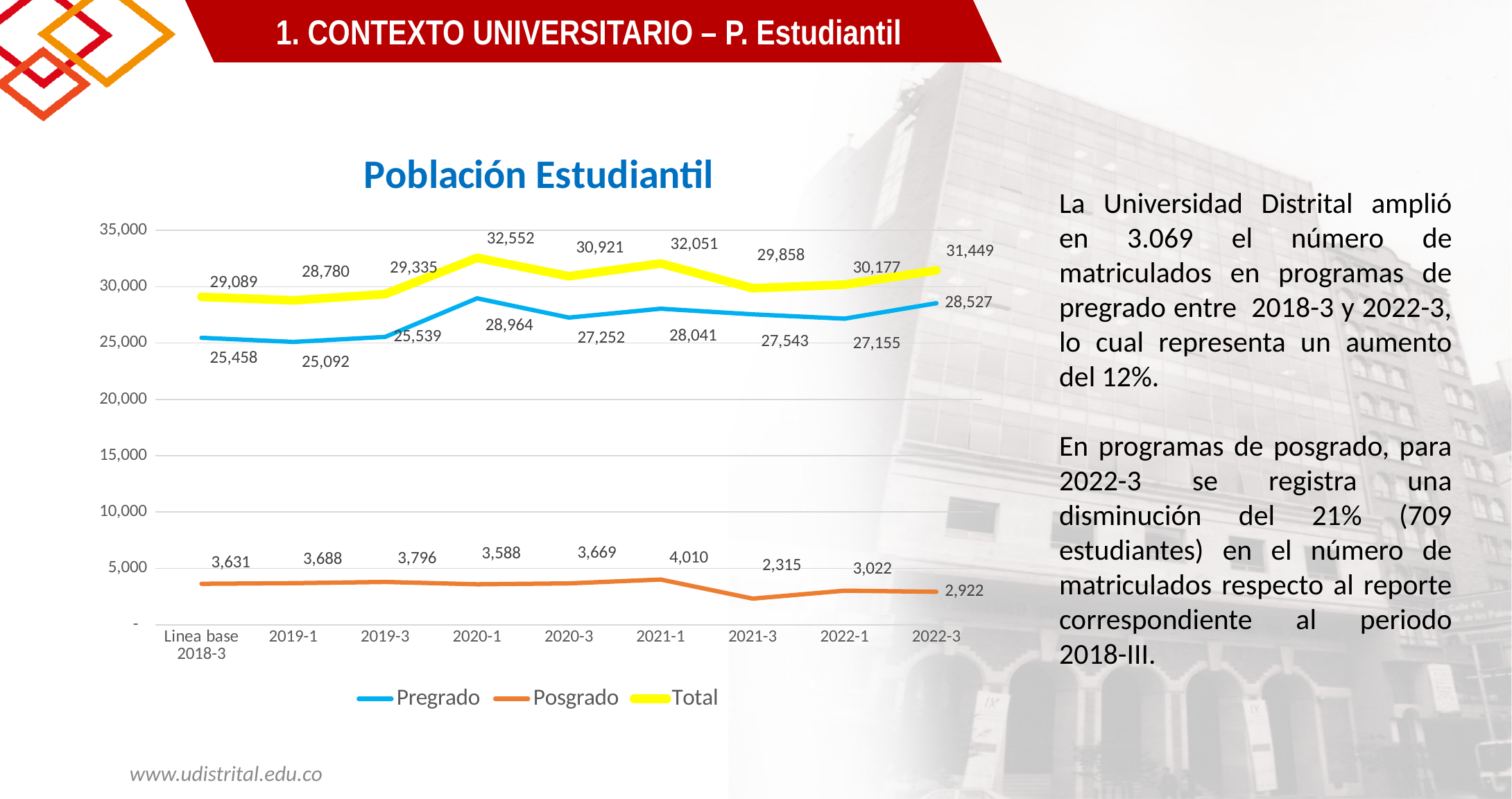
What is the title of the chart? Población Estudiantil What is the Total value for 2022-3? 31,449 What is the Posgrado value for 2021-3? 2,315 What is the difference between the Pregrado values for 2022-3 and Linea base 2018-3? 3,069 How many series does the legend list? 3 In which period is the Posgrado value lowest? 2021-3 In which period is the Total highest? 2020-1 Is the Total value for 2019-1 greater or less than 30,000? less What is the Pregrado value for 2020-1? 28,964 Which is larger, the Posgrado value for 2021-1 or for 2022-1? 2021-1 How many periods are plotted along the x axis? 9 What type of chart is shown on the slide? Line chart